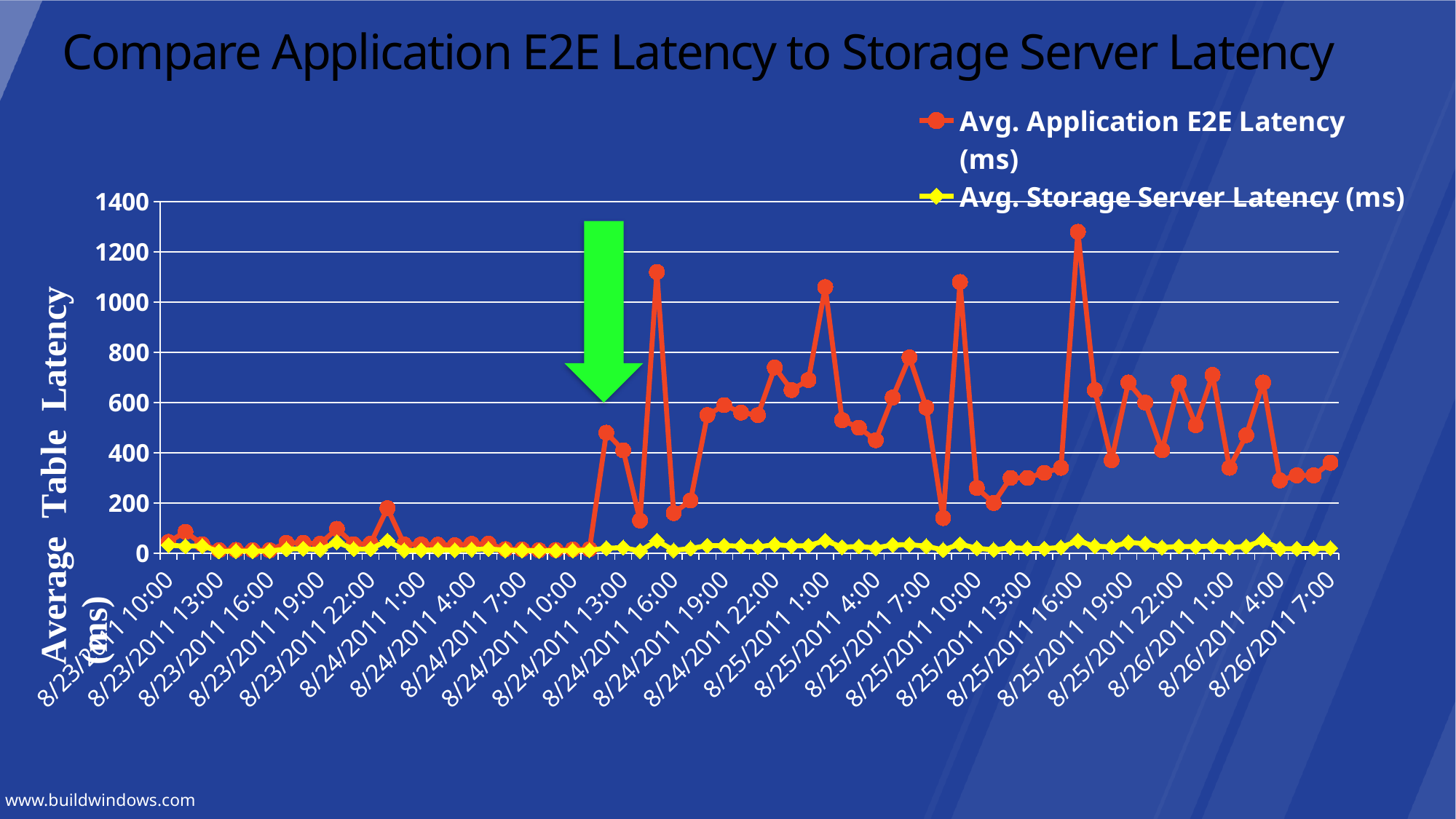
Is the Avg. Storage Server Latency at 8/25/2011 16:00 greater or less than 200? less What is the label on the vertical axis of the chart? Average Table Latency (ms) What kind of chart is shown on the slide? line chart How many series does the legend list? 2 Is the Avg. Application E2E Latency at 8/23/2011 10:00 greater or less than 200? less What is the highest value shown on the vertical axis? 1400 What is the title of the chart on the slide? Compare Application E2E Latency to Storage Server Latency Is the Avg. Application E2E Latency at 8/24/2011 16:00 greater or less than 1000? less At 8/25/2011 16:00, which series has the larger value, Avg. Application E2E Latency or Avg. Storage Server Latency? Avg. Application E2E Latency (ms) Does the Avg. Application E2E Latency generally rise or fall from 8/23/2011 to 8/25/2011? rise Which series reaches the highest value on the chart? Avg. Application E2E Latency (ms)